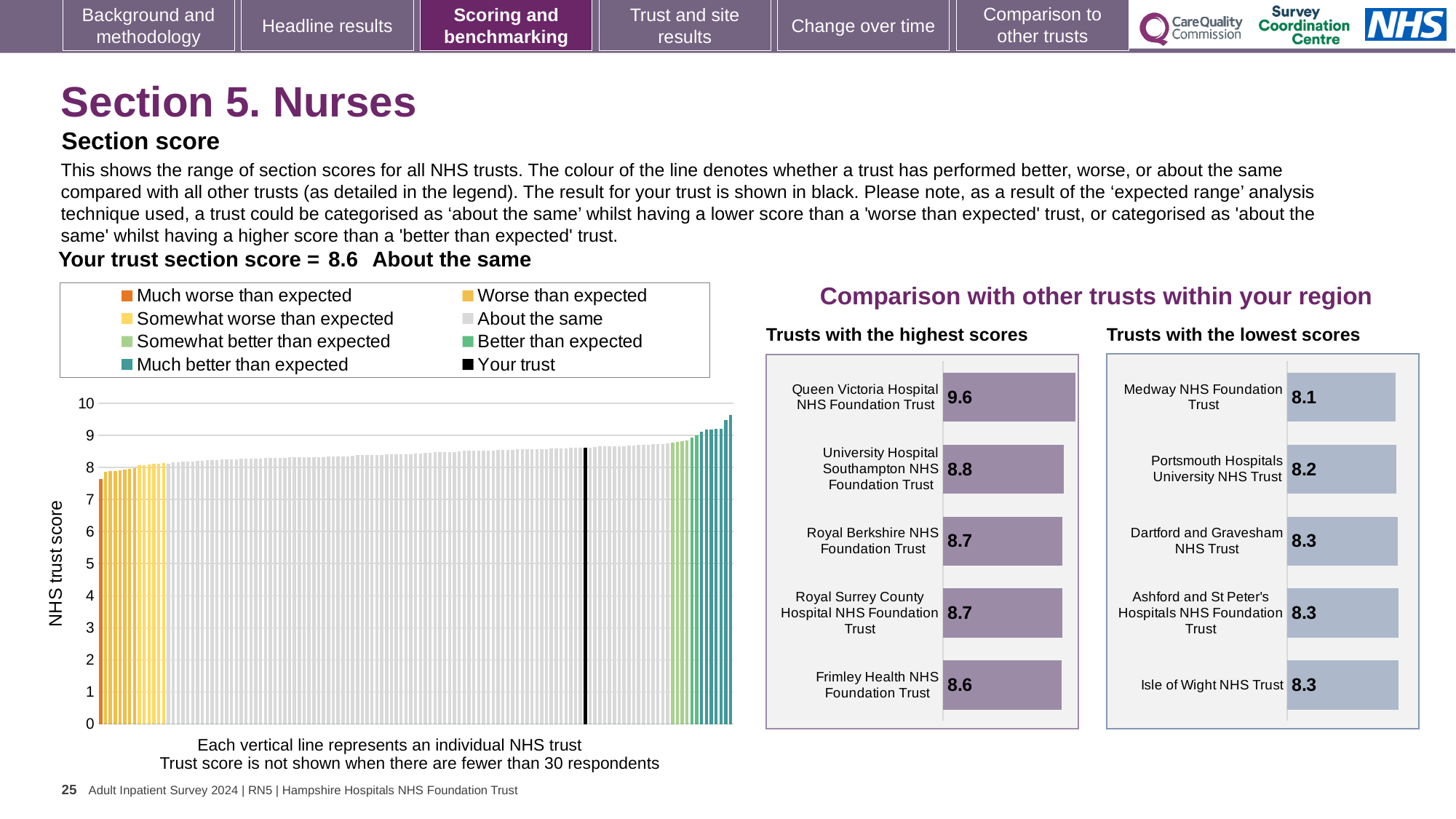
What kind of chart is the main chart on the left showing all NHS trusts? bar chart In the 'Trusts with the lowest scores' chart, how many trusts are shown? 5 In the 'Trusts with the highest scores' chart, what is the score for Queen Victoria Hospital NHS Foundation Trust? 9.6 In the main chart of all NHS trusts on the left, what is the section score for your trust? 8.6 In the 'Trusts with the highest scores' chart, which trust has the highest score? Queen Victoria Hospital NHS Foundation Trust In the 'Trusts with the lowest scores' chart, what is the score for Medway NHS Foundation Trust? 8.1 In the main chart on the left, do the trust scores rise or fall from left to right? rise In the 'Trusts with the highest scores' chart, what is the difference between the scores of Queen Victoria Hospital NHS Foundation Trust and Frimley Health NHS Foundation Trust? 1.0 In the 'Trusts with the lowest scores' chart, which trust has the lowest score? Medway NHS Foundation Trust How many entries does the legend of the main chart on the left list? 8 In the 'Trusts with the lowest scores' chart, what is the difference between the scores of Isle of Wight NHS Trust and Medway NHS Foundation Trust? 0.2 In the 'Trusts with the highest scores' chart, which has the higher score: University Hospital Southampton NHS Foundation Trust or Royal Berkshire NHS Foundation Trust? University Hospital Southampton NHS Foundation Trust